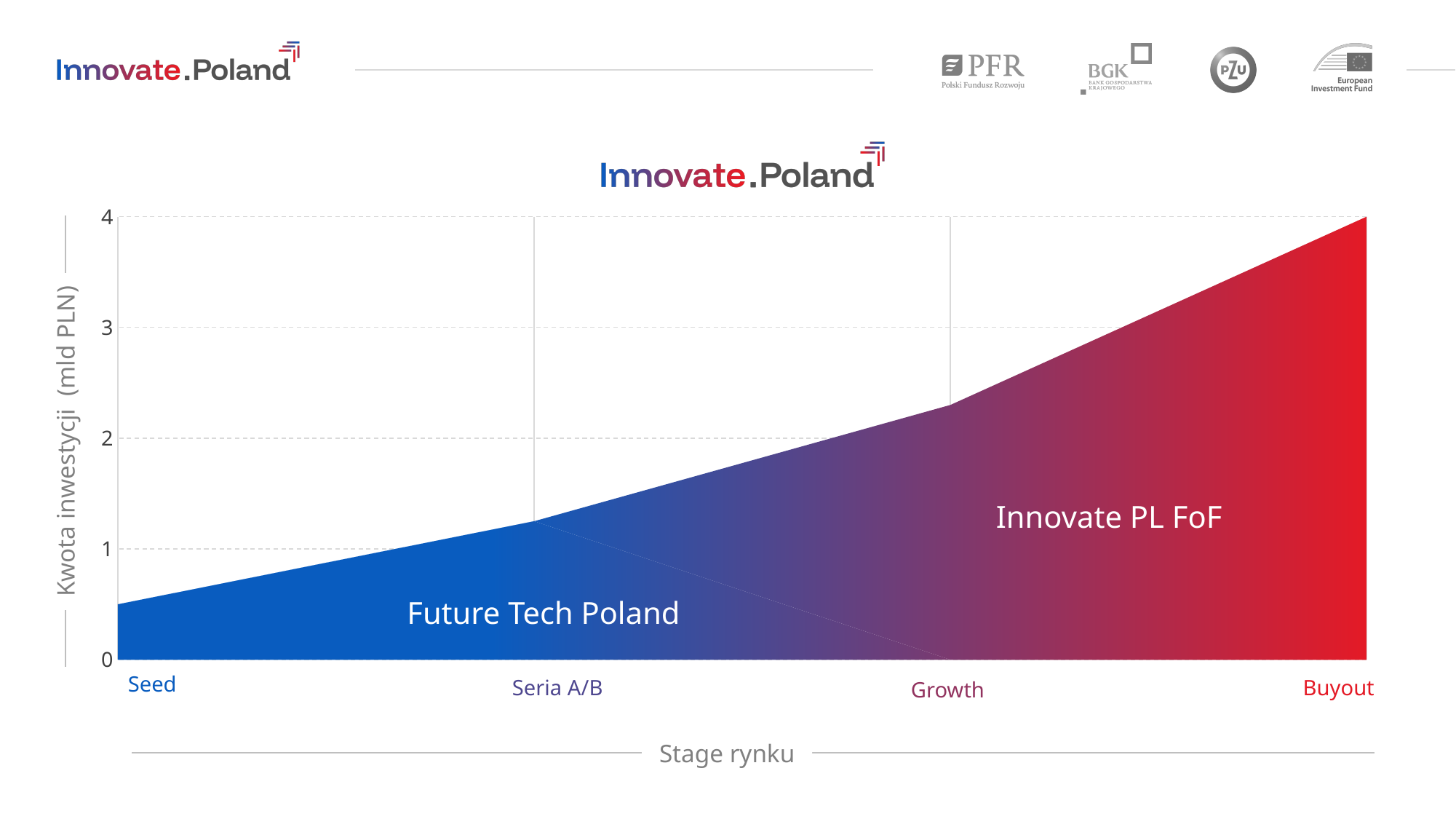
Do the values rise or fall from Seed to Buyout? rise What is the title of the x axis? Stage rynku Which stage has the highest investment amount? Buyout How many stages are shown along the x axis? 4 What is the title of the y axis? Kwota inwestycji (mld PLN) Is the value for Growth greater or less than 3? less Which stage has a larger value, Seria A/B or Growth? Growth What kind of chart is shown on the slide? area chart Is the value for Seed greater or less than 1? less Which stage has the lowest investment amount? Seed What is the investment amount (mld PLN) at the Buyout stage? 4 Is the value for Growth greater or less than 2? greater